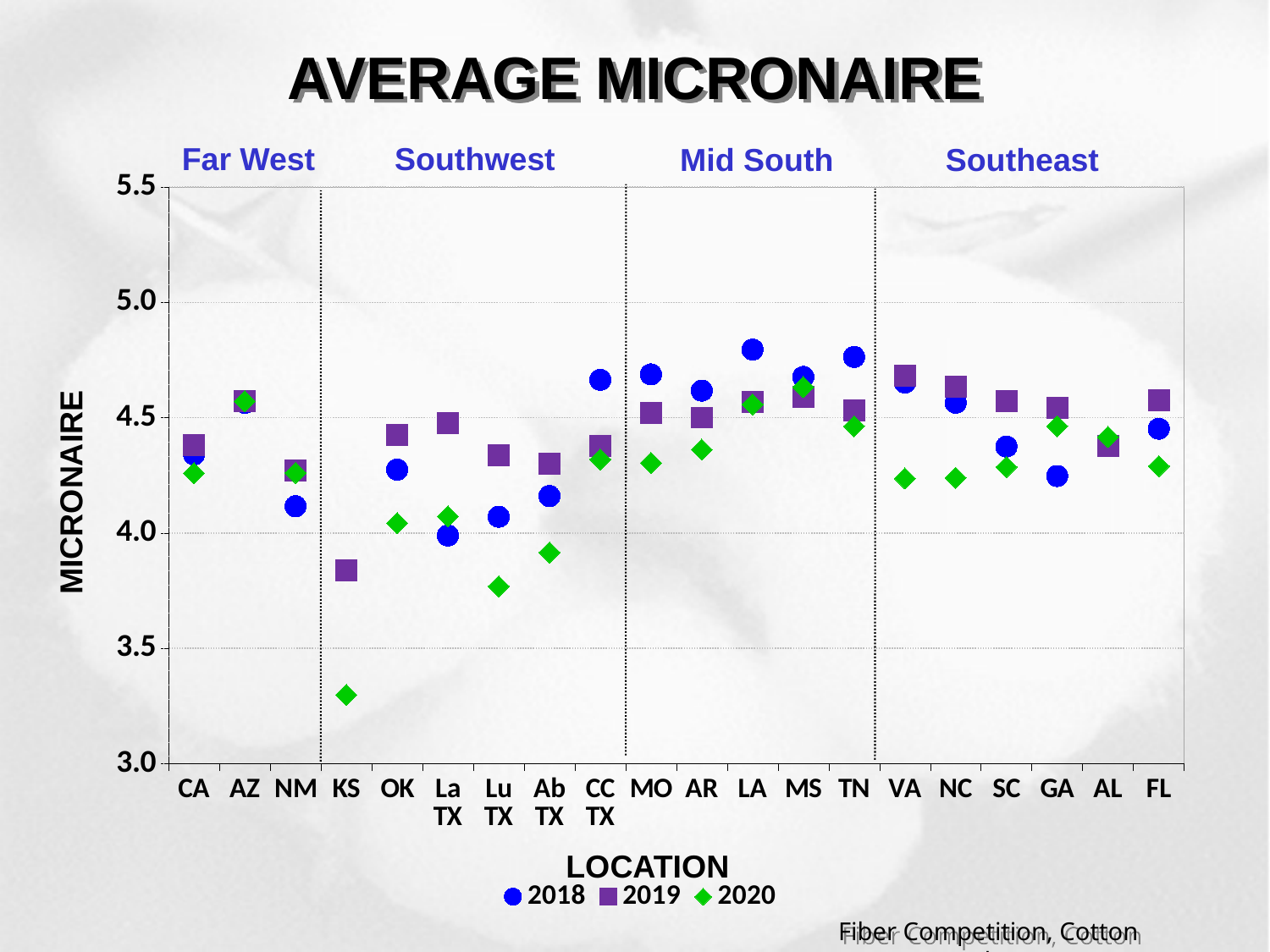
At OK, which is larger, the 2019 value or the 2020 value? 2019 What is the title of the y axis? MICRONAIRE Is the 2020 value for KS greater or less than 3.5? less How many locations are shown along the x axis? 20 Is the 2019 value for KS greater or less than 4.0? less Which location has the lowest 2020 value? KS What kind of chart is shown on the slide? scatter chart At GA, which is larger, the 2018 value or the 2020 value? 2020 How many series does the legend list? 3 Is the 2018 value for LA greater or less than 4.5? greater Which location has the lowest 2019 value? KS